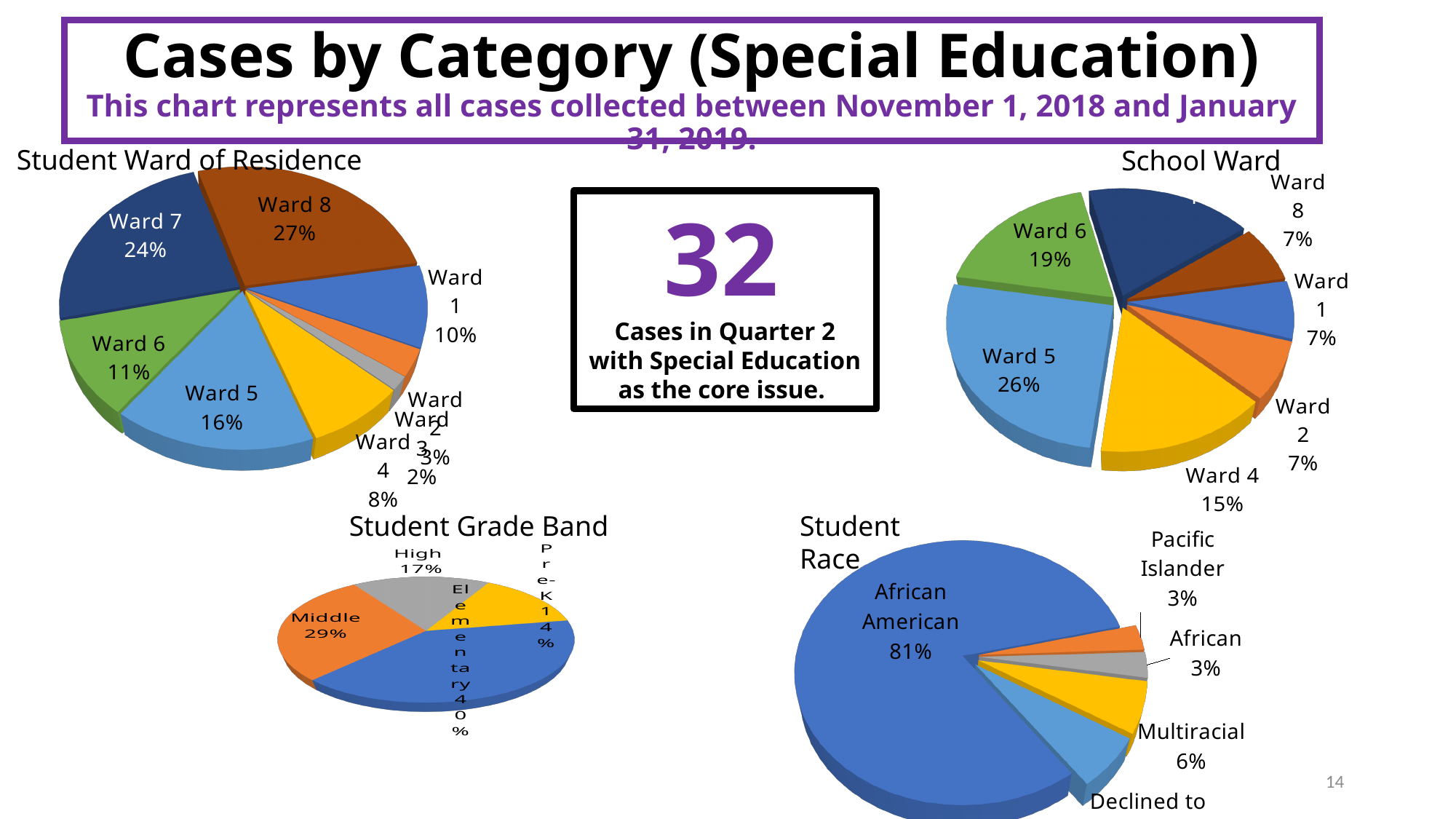
In the Student Race chart, what share of cases is Multiracial? 6% In the Student Race chart, what share of cases is African American? 81% In the Student Ward of Residence chart, what share of cases is Ward 8? 27% In the Student Ward of Residence chart, which ward has the largest share? Ward 8 In the Student Grade Band chart, what share of cases is Middle? 29% In the Student Ward of Residence chart, what is the difference in percentage points between Ward 7 and Ward 5? 8 In the School Ward chart, what share of cases is Ward 4? 15% In the Student Ward of Residence chart, which ward has the smallest share? Ward 3 In the School Ward chart, what share of cases is Ward 5? 26% In the School Ward chart, which is larger, Ward 6 or Ward 4? Ward 6 In the Student Grade Band chart, which grade band has the largest share? Elementary What kind of chart is the Student Grade Band chart? Pie chart